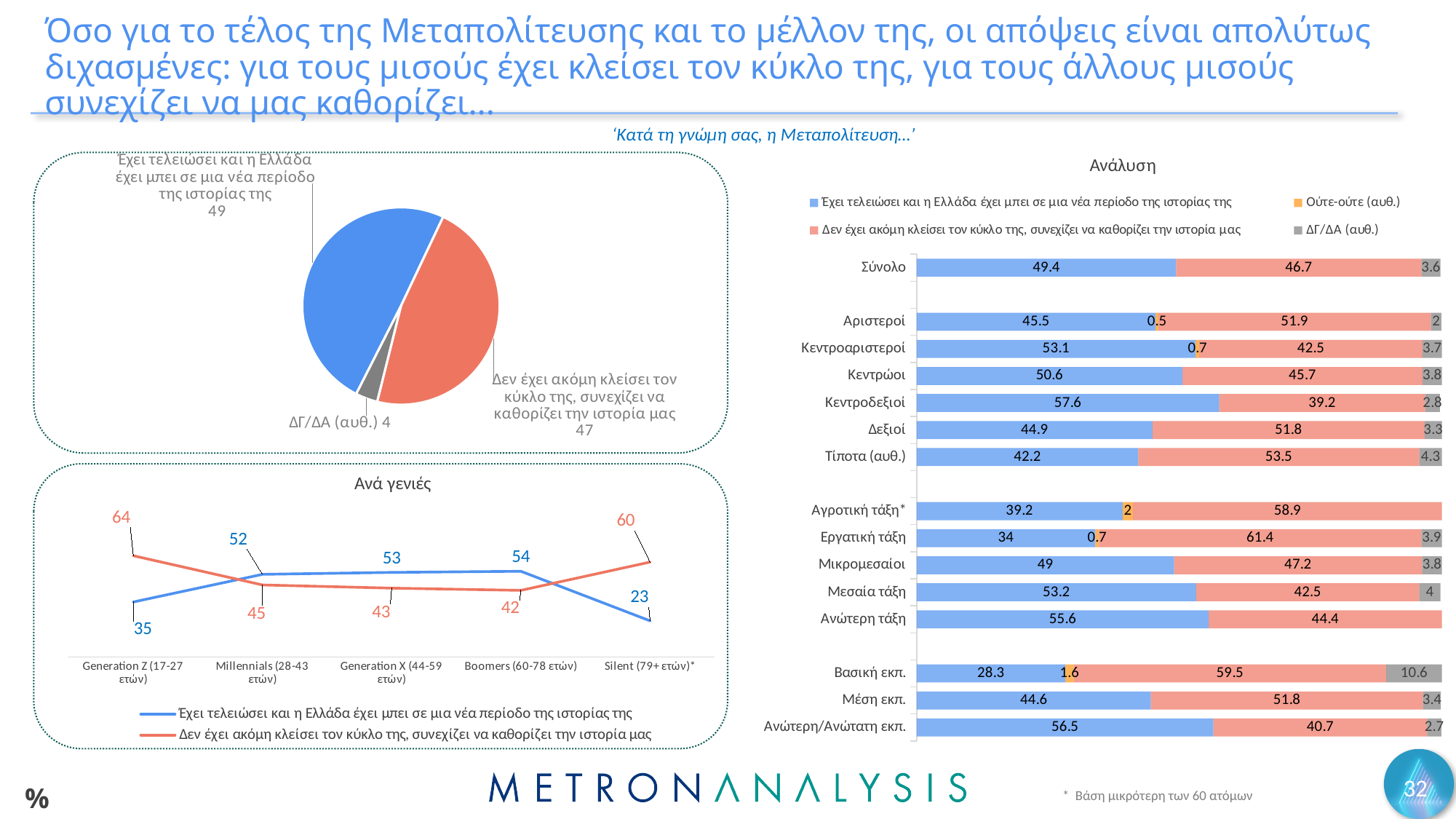
In the 'Ανάλυση' chart, which is larger for Εργατική τάξη: the blue value or the red value? the red value (61.4) In the 'Ανάλυση' chart, what is the value of 'Έχει τελειώσει...' (blue) for Σύνολο? 49.4 In the top-left pie chart, what share is shown for 'Έχει τελειώσει και η Ελλάδα έχει μπει σε μια νέα περίοδο της ιστορίας της'? 49 In the 'Ανά γενιές' chart, what is the value of the red series ('Δεν έχει ακόμη κλείσει τον κύκλο της...') for Generation Z (17-27 ετών)? 64 In the 'Ανά γενιές' chart, which generation has the lowest value for the blue series ('Έχει τελειώσει...')? Silent (79+ ετών)* In the top-left pie chart, what value is shown for 'ΔΓ/ΔΑ (αυθ.)'? 4 In the 'Ανά γενιές' chart, how many generation categories are shown on the x axis? 5 In the 'Ανάλυση' chart, which category has the highest value for the blue series 'Έχει τελειώσει...'? Κεντροδεξιοί What kind of chart is the top-left chart on the slide? pie chart In the 'Ανάλυση' chart, what is the value of 'ΔΓ/ΔΑ (αυθ.)' (grey) for Βασική εκπ.? 10.6 In the 'Ανάλυση' chart, how many series does the legend list? 4 In the 'Ανά γενιές' chart, what is the difference between the blue and red values for Boomers (60-78 ετών)? 12